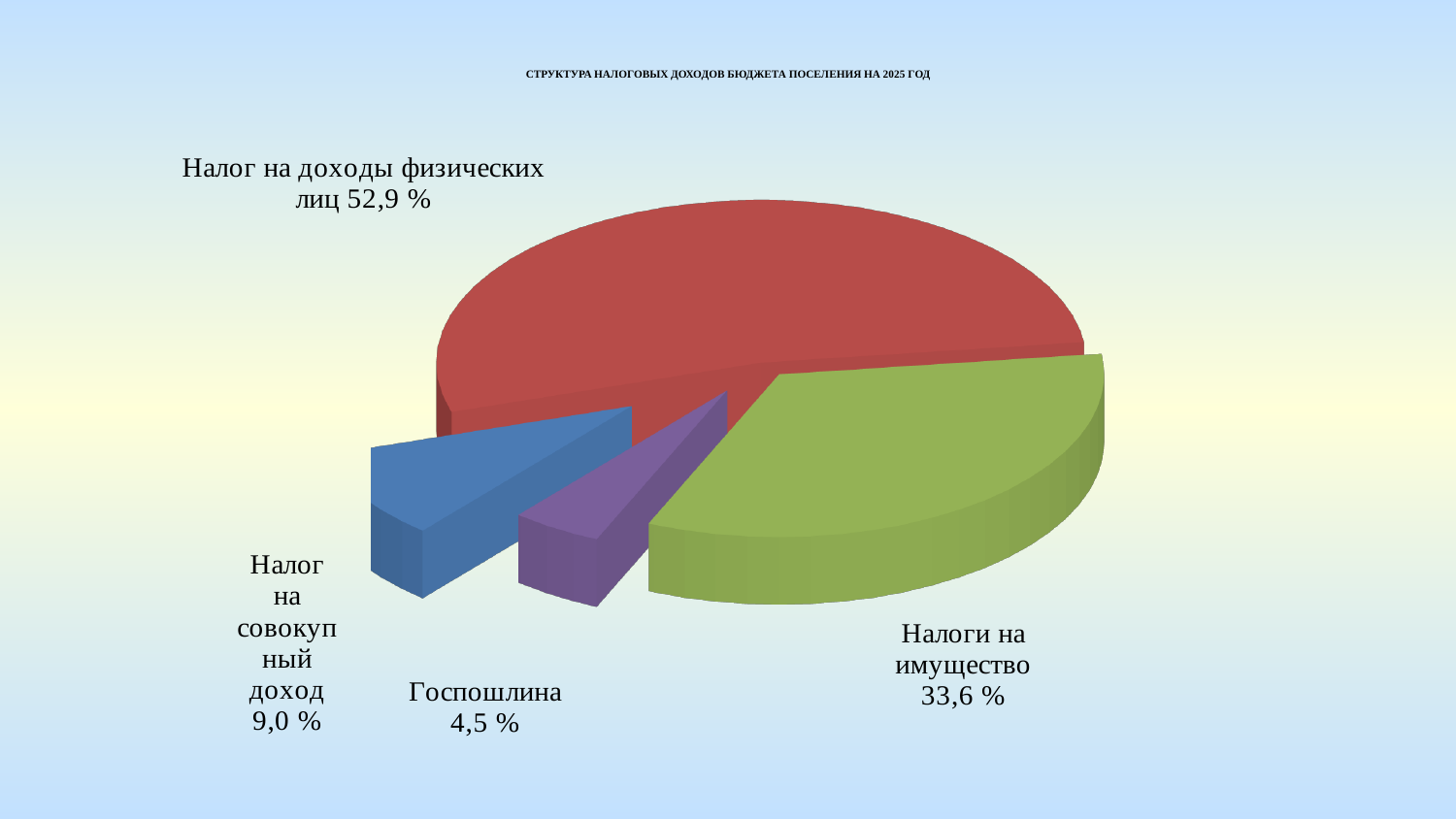
Каким цветом показан сектор «Налоги на имущество»? Зелёным Какова доля налога на совокупный доход? 9,0 % Какова доля налога на доходы физических лиц в структуре налоговых доходов? 52,9 % Какой вид налоговых доходов имеет наименьшую долю? Госпошлина Как называется диаграмма на слайде? Структура налоговых доходов бюджета поселения на 2025 год На сколько процентных пунктов доля налога на доходы физических лиц больше доли налогов на имущество? 19,3 Сколько секторов (категорий) показано на круговой диаграмме? 4 Какой вид налоговых доходов имеет наибольшую долю? Налог на доходы физических лиц Что больше: доля налога на совокупный доход или доля госпошлины? Налог на совокупный доход Какова доля госпошлины? 4,5 % Какой тип диаграммы показан на слайде? Круговая диаграмма Какова доля налогов на имущество? 33,6 %